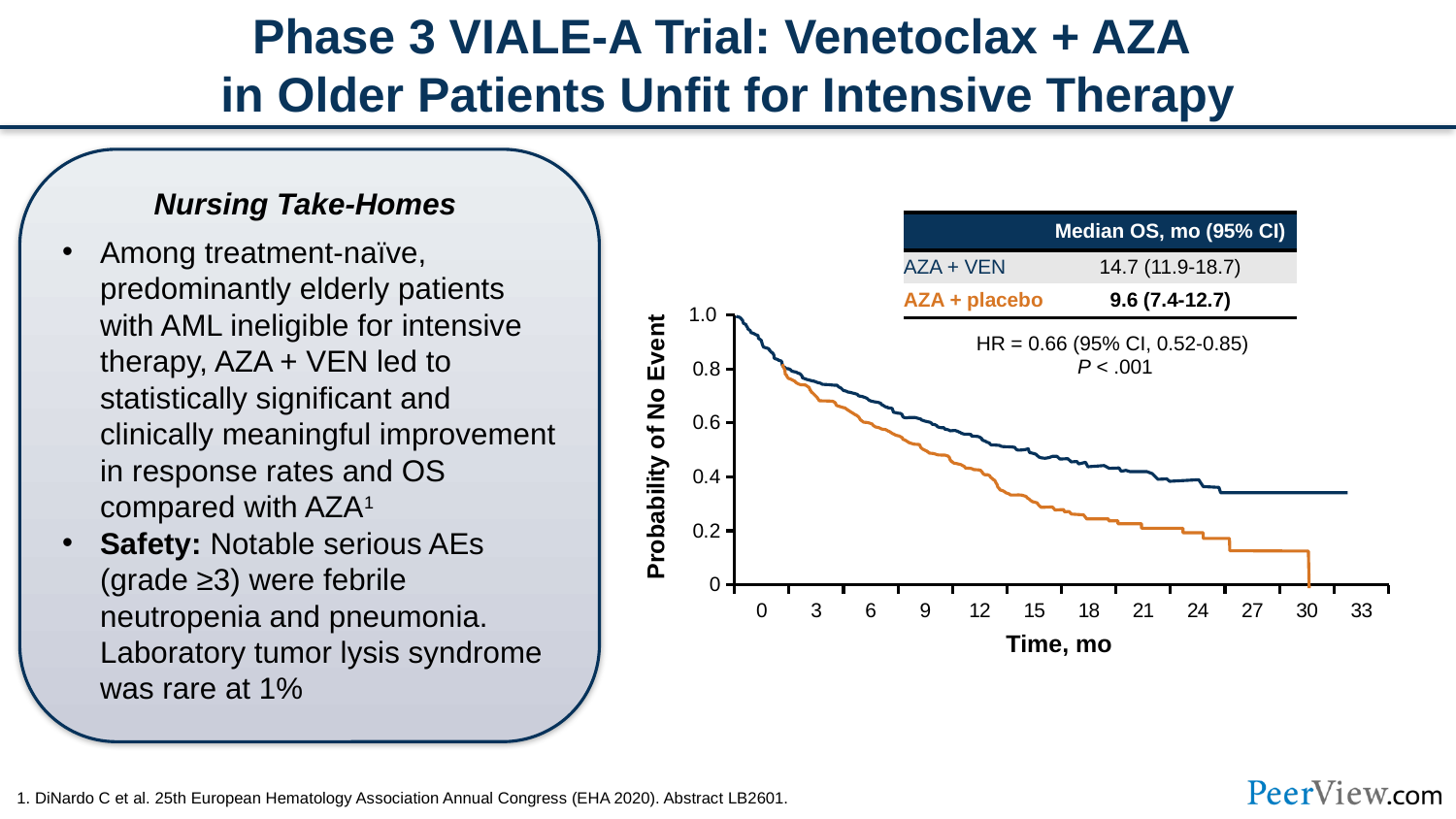
What kind of chart is shown on the slide? Line chart (Kaplan-Meier survival curve) What is the median OS for AZA + placebo? 9.6 (7.4-12.7) What is the P value shown on the chart? P < .001 Which arm has the higher median OS, AZA + VEN or AZA + placebo? AZA + VEN What is the difference in median OS (months) between AZA + VEN and AZA + placebo? 5.1 Do the curves rise or fall as time increases along the x axis? Fall Is the probability of no event for AZA + VEN at 30 months greater or less than 0.2? greater How many treatment arms (series) are plotted on the chart? 2 Is the probability of no event for AZA + placebo at 24 months greater or less than 0.4? less What is the hazard ratio shown on the chart? HR = 0.66 (95% CI, 0.52-0.85) What is the label of the y axis? Probability of No Event What is the median OS for AZA + VEN? 14.7 (11.9-18.7)